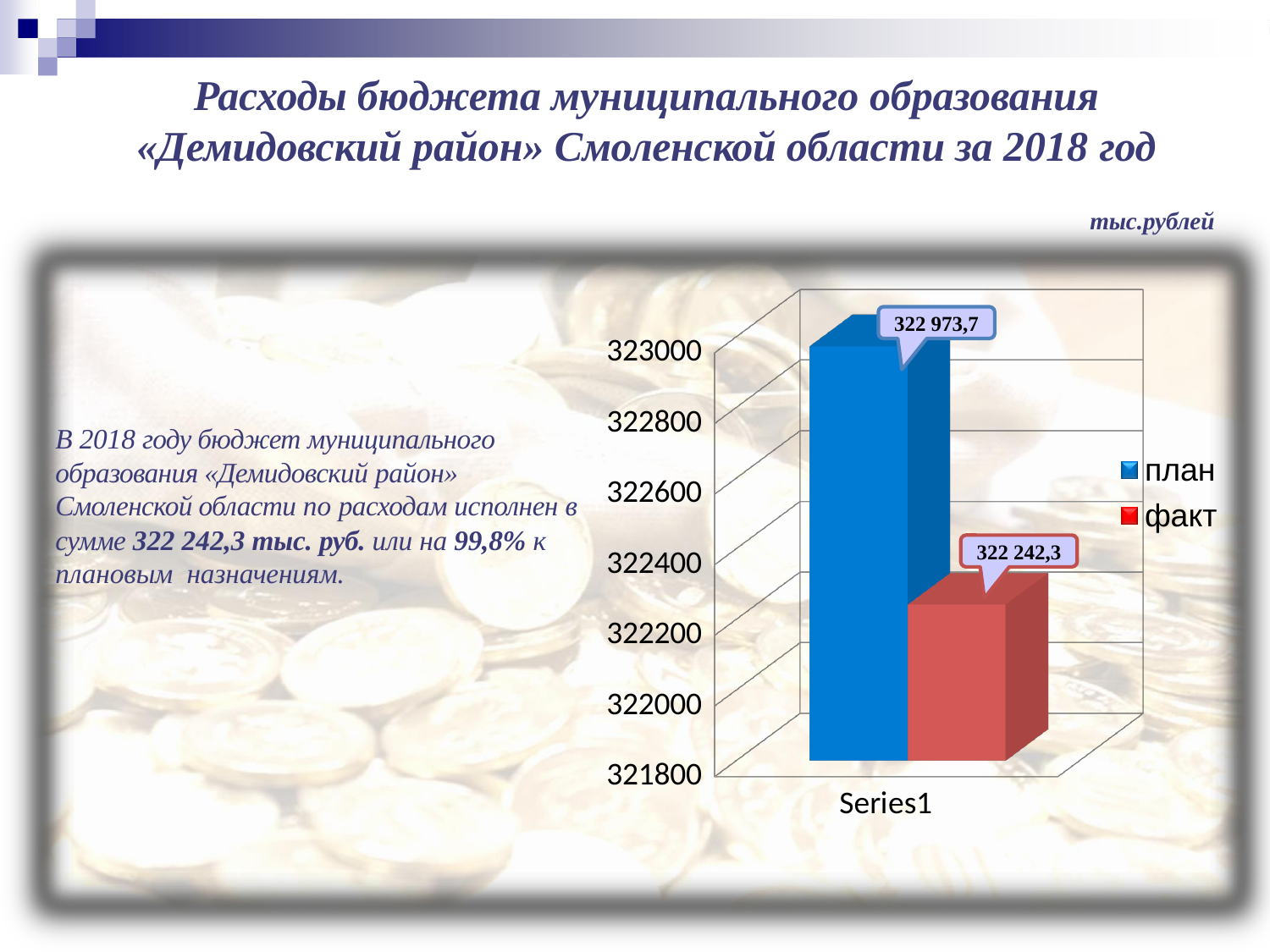
What colour is the bar for факт? red What kind of chart is shown on the slide? bar chart What unit of measurement is indicated above the chart? тыс.рублей What is the difference between the план value and the факт value? 731,4 Is the value for план greater or less than 322800? greater How many series does the legend list? 2 What is the value for факт (fact) on the chart? 322 242,3 Which series has the lowest value on the chart? факт Which series has the highest value on the chart? план Which series has the higher value, план or факт? план What is the value for план (plan) on the chart? 322 973,7 Is the value for факт greater or less than 322400? less